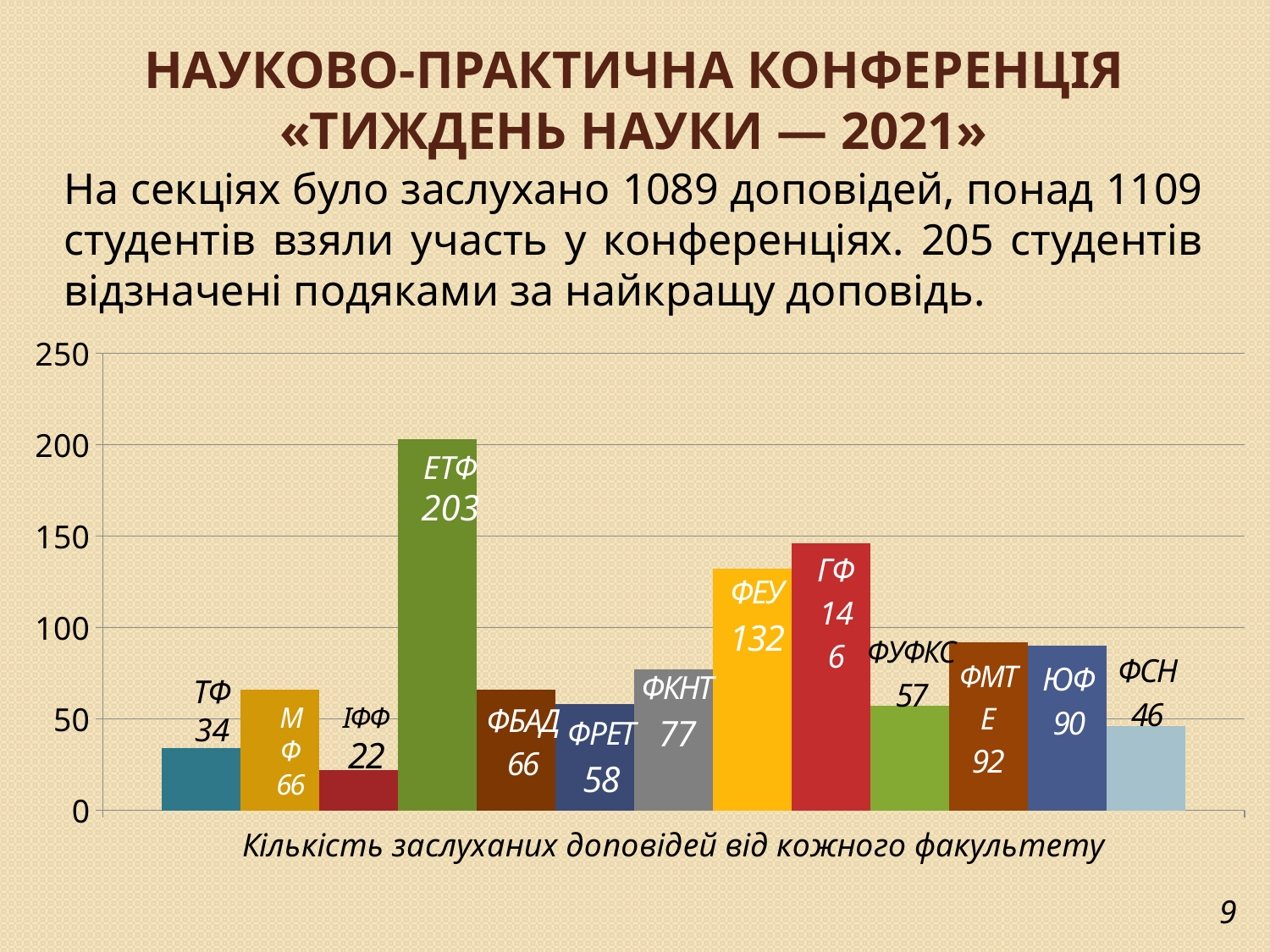
Which faculty has the highest value in the chart? ЕТФ What is the text shown below the chart's horizontal axis? Кількість заслуханих доповідей від кожного факультету Is the value for ФКНТ greater or less than 100? less What is the value for ІФФ? 22 Which faculty has the lowest value in the chart? ІФФ What is the value for ФЕУ? 132 What is the difference between the values for ГФ and ФЕУ? 14 What is the value for ФСН? 46 What type of chart is shown on the slide? bar chart What is the value for ЕТФ? 203 Which is larger, the value for ФМТЕ or the value for ЮФ? ФМТЕ How many faculties (bars) are shown in the chart? 13